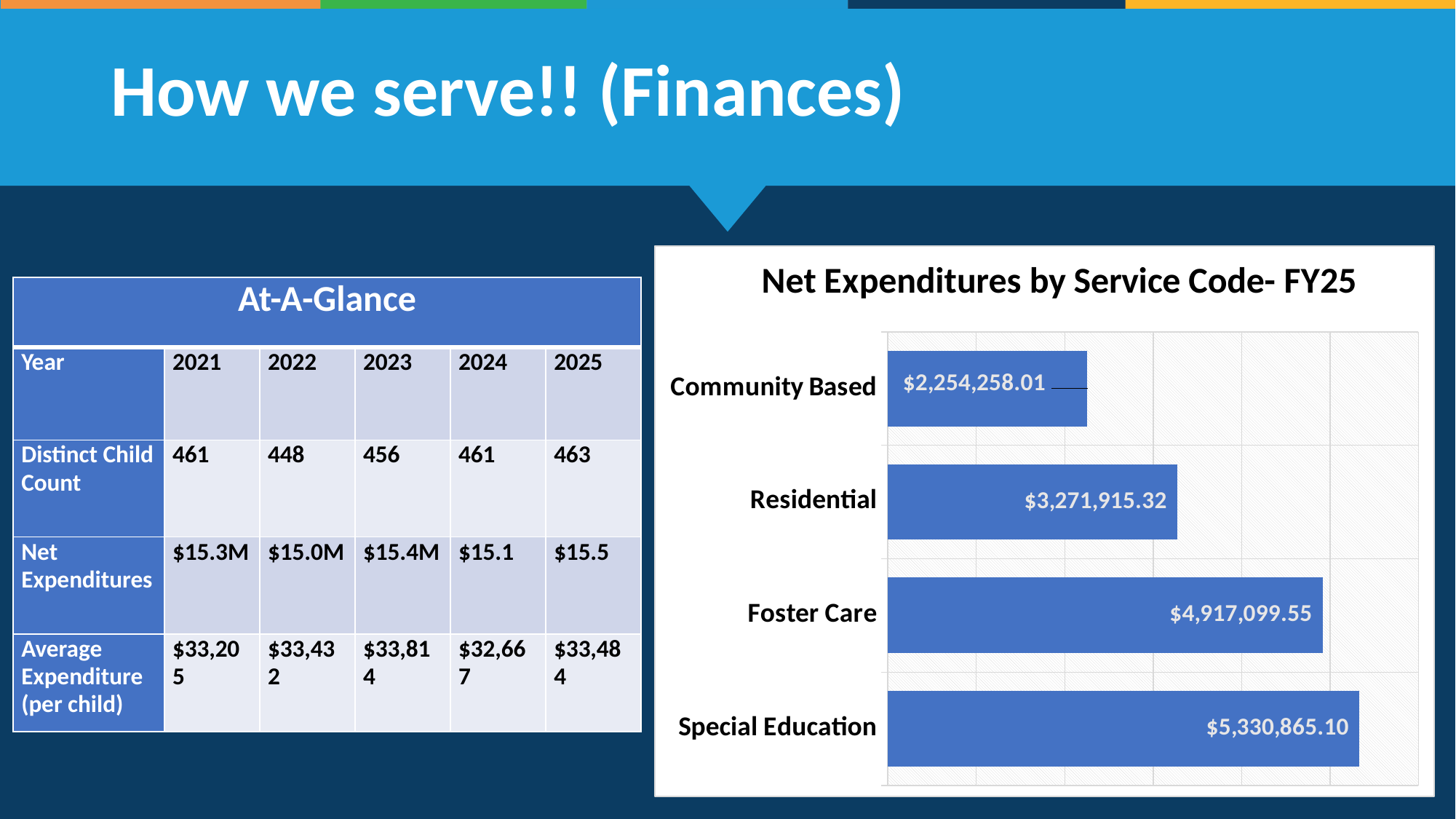
Which has a larger net expenditure in the chart, Residential or Foster Care? Foster Care Which service code has the lowest net expenditure in the chart? Community Based What is the net expenditure for Residential services in the chart? $3,271,915.32 What type of chart is used to show Net Expenditures by Service Code- FY25? Bar chart How many service codes are shown in the Net Expenditures by Service Code- FY25 chart? 4 What is the difference between the Special Education and Foster Care net expenditures in the chart? $413,765.55 What is the difference between the Residential and Community Based net expenditures in the chart? $1,017,657.31 What is the net expenditure for Special Education in the chart? $5,330,865.10 What is the net expenditure for Community Based services in the chart? $2,254,258.01 Which service code has the highest net expenditure in the chart? Special Education What is the title of the chart on the slide? Net Expenditures by Service Code- FY25 What is the net expenditure for Foster Care in the Net Expenditures by Service Code- FY25 chart? $4,917,099.55